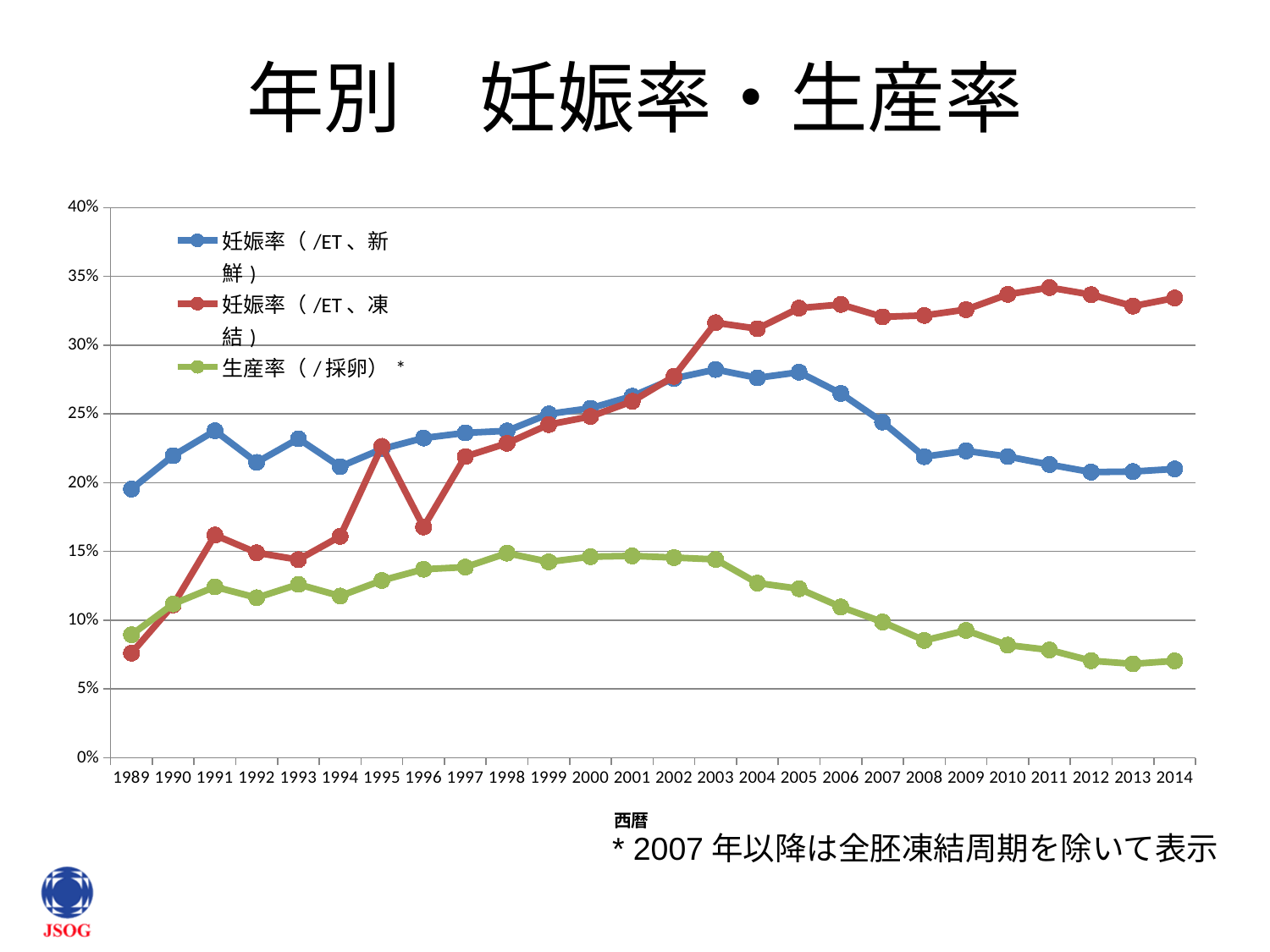
In which year is 妊娠率（/ET、凍結） at its lowest? 1989 Which series has the lowest value in 2000? 生産率（/採卵） Is the value for 妊娠率（/ET、凍結） in 1996 greater or less than 20%? less What kind of chart is shown on the slide? line chart Is the value for 妊娠率（/ET、新鮮） in 2003 greater or less than 25%? greater In 2014, which is larger: 妊娠率（/ET、凍結） or 妊娠率（/ET、新鮮）? 妊娠率（/ET、凍結） In 1989, which is larger: 妊娠率（/ET、新鮮） or 妊娠率（/ET、凍結）? 妊娠率（/ET、新鮮） How many years are plotted along the x axis? 26 Does 生産率（/採卵） rise or fall from 2003 to 2014? fall Is the value for 妊娠率（/ET、凍結） in 2014 greater or less than 30%? greater How many series does the legend list? 3